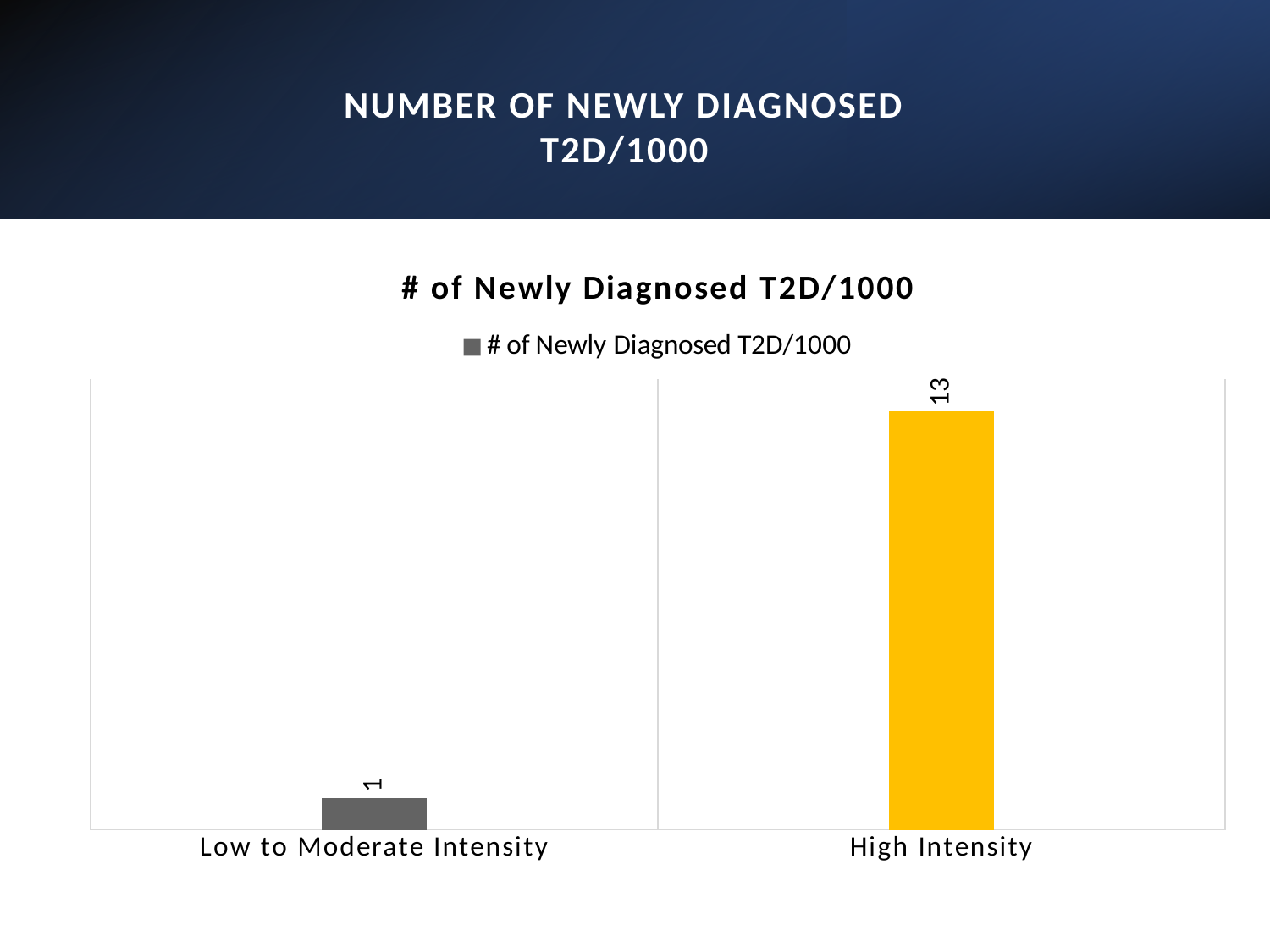
What is the title of the chart? # of Newly Diagnosed T2D/1000 How many series does the legend list? 1 How many categories are shown on the x axis? 2 What colour is the bar for High Intensity? Yellow Which category has the highest number of newly diagnosed T2D/1000? High Intensity What is the difference between the High Intensity and Low to Moderate Intensity values? 12 Which is larger, the value for High Intensity or the value for Low to Moderate Intensity? High Intensity Which category has the lowest number of newly diagnosed T2D/1000? Low to Moderate Intensity What is the value for Low to Moderate Intensity? 1 What is the value for High Intensity? 13 What kind of chart is shown on the slide? Bar chart Do the values rise or fall from Low to Moderate Intensity to High Intensity? Rise